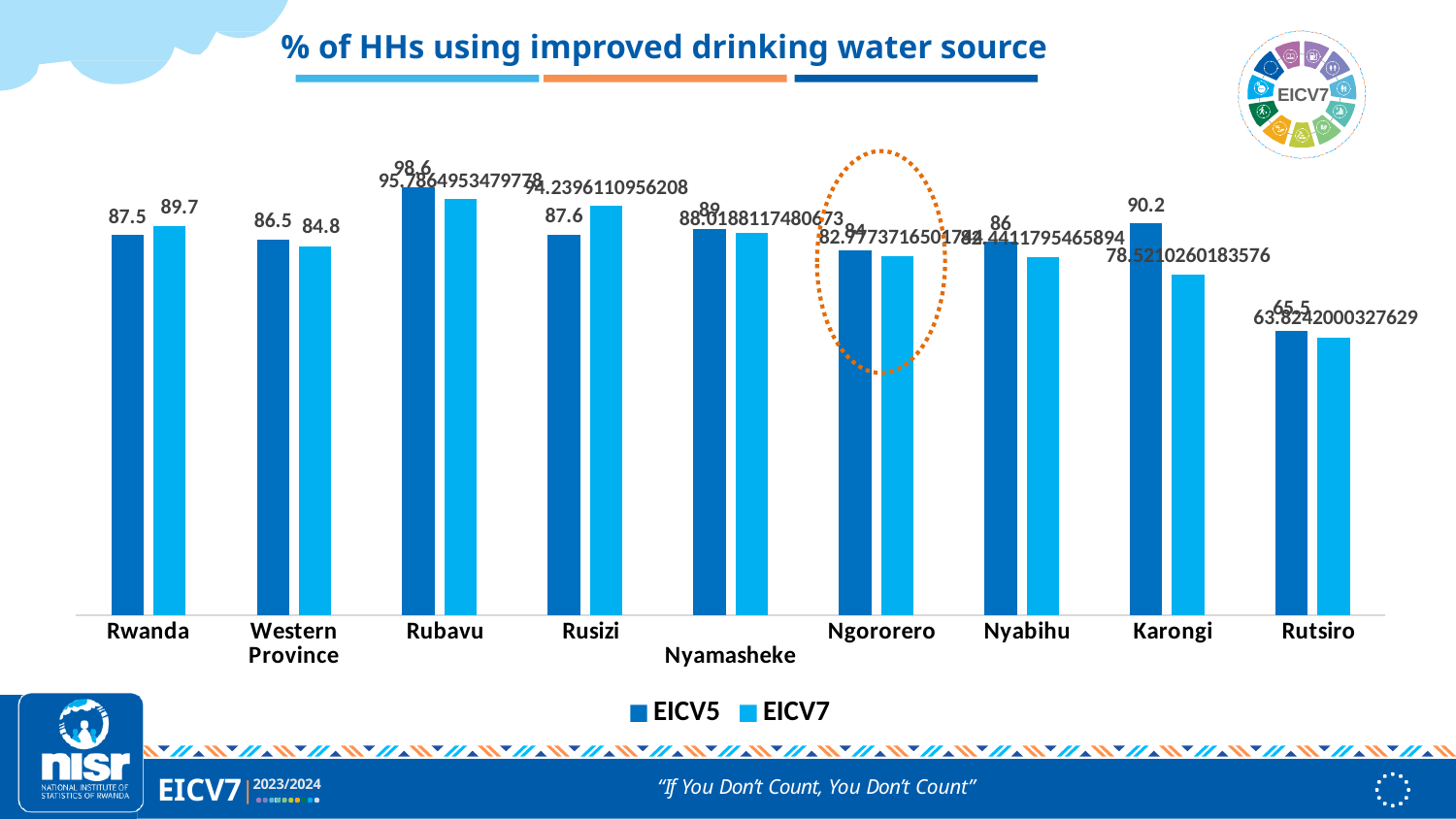
What is the EICV5 value for Karongi? 90.2 Which category's bars are highlighted with a dotted orange circle? Ngororero Which category has the lowest EICV7 value? Rutsiro What is the difference between the EICV7 and EICV5 values for Rwanda? 2.2 What is the EICV7 value for Rwanda? 89.7 How many series does the legend list? 2 What kind of chart is shown on the slide? Bar chart Which category has the highest EICV5 value? Rubavu What is the EICV5 value for Western Province? 86.5 Which is larger for Karongi, the EICV5 value or the EICV7 value? EICV5 What is the EICV5 value for Rutsiro? 65.5 How many categories are shown on the x axis? 9